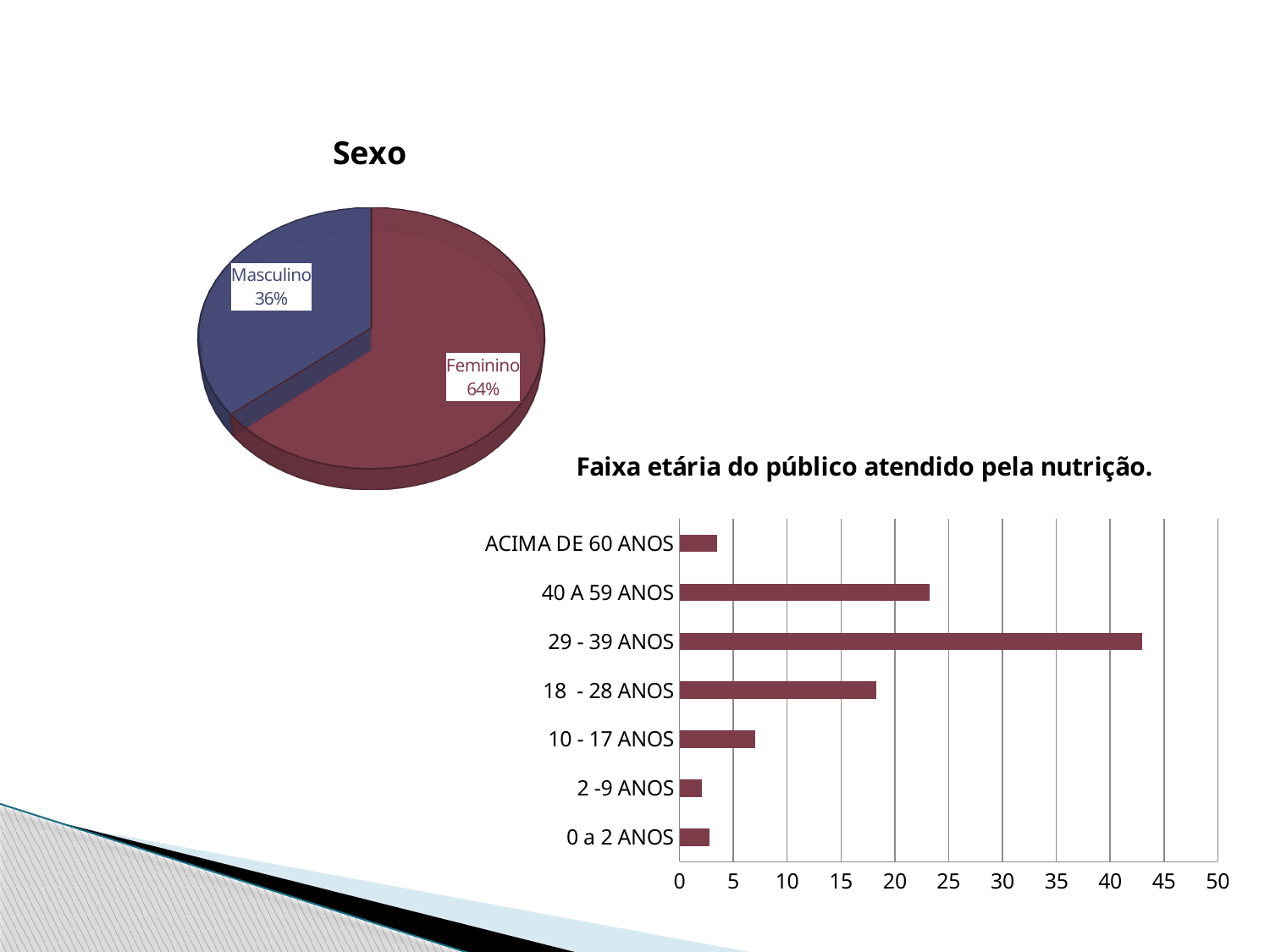
In the pie chart titled "Sexo", what share is Masculino? 36% In the pie chart titled "Sexo", what share is Feminino? 64% In the pie chart titled "Sexo", which slice is larger, Masculino or Feminino? Feminino In the chart titled "Faixa etária do público atendido pela nutrição.", which age category has the highest value? 29 - 39 ANOS In the chart titled "Faixa etária do público atendido pela nutrição.", is the value for 40 A 59 ANOS greater or less than 20? greater In the chart titled "Faixa etária do público atendido pela nutrição.", how many age categories are shown? 7 In the pie chart titled "Sexo", how many slices are there? 2 What kind of chart is the chart titled "Sexo"? Pie chart What kind of chart is the chart titled "Faixa etária do público atendido pela nutrição."? Bar chart In the chart titled "Faixa etária do público atendido pela nutrição.", is the value for 29 - 39 ANOS greater or less than 40? greater In the chart titled "Faixa etária do público atendido pela nutrição.", is the value for ACIMA DE 60 ANOS greater or less than 5? less In the chart titled "Faixa etária do público atendido pela nutrição.", which is larger, the value for 40 A 59 ANOS or the value for 18 - 28 ANOS? 40 A 59 ANOS